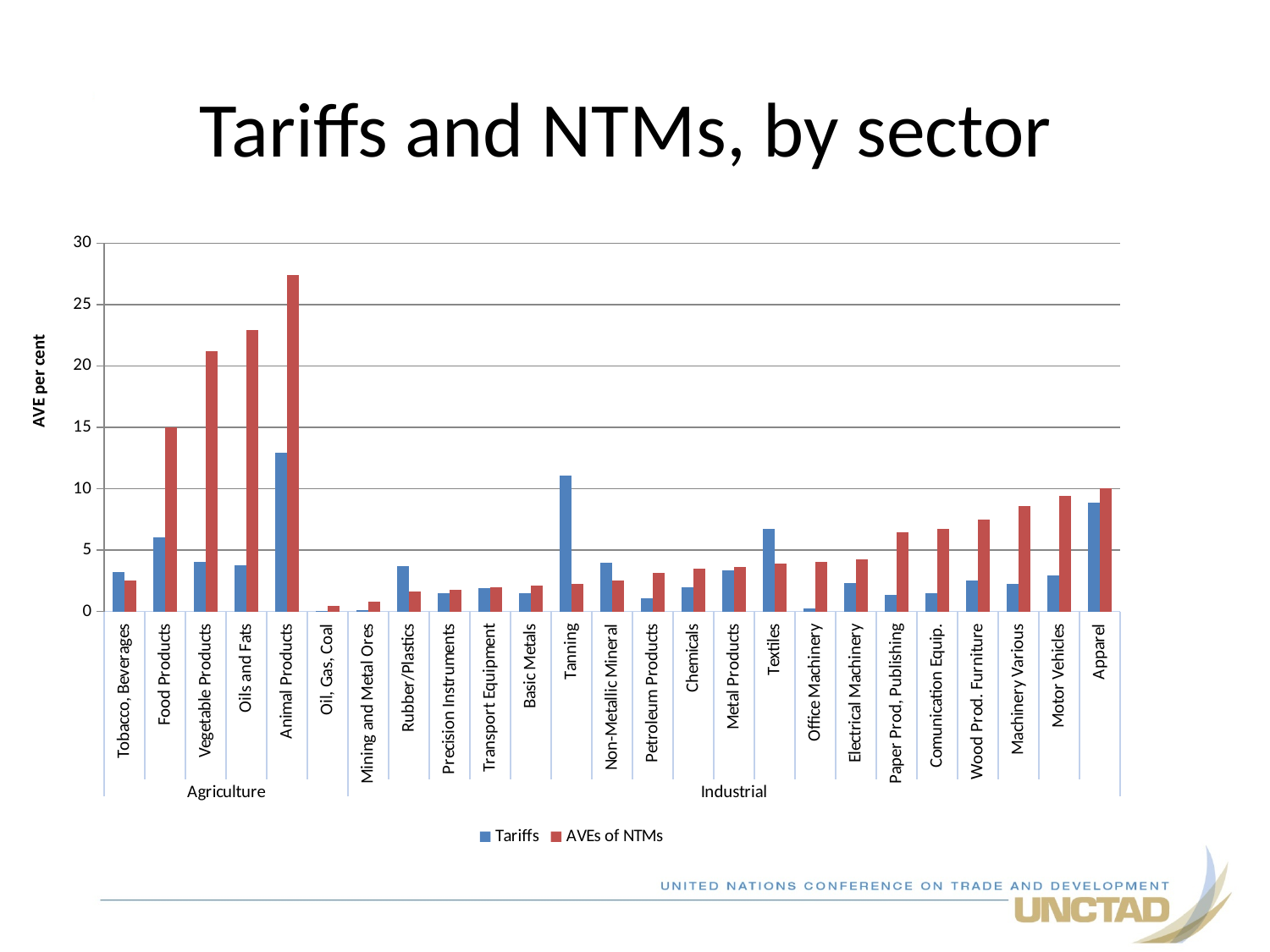
Which sector has the highest Tariffs value? Animal Products Is the AVEs of NTMs value for Vegetable Products greater or less than 20? greater Which sector has the highest AVEs of NTMs value? Animal Products Is the Tariffs value for Apparel greater or less than 10? less For Tanning, which is larger: Tariffs or AVEs of NTMs? Tariffs How many series does the legend list? 2 What is the label on the vertical axis? AVE per cent How many sectors are shown along the x axis? 25 How many sectors are grouped under Agriculture? 6 What kind of chart is shown on the slide? bar chart Is the AVEs of NTMs value for Animal Products greater or less than 25? greater